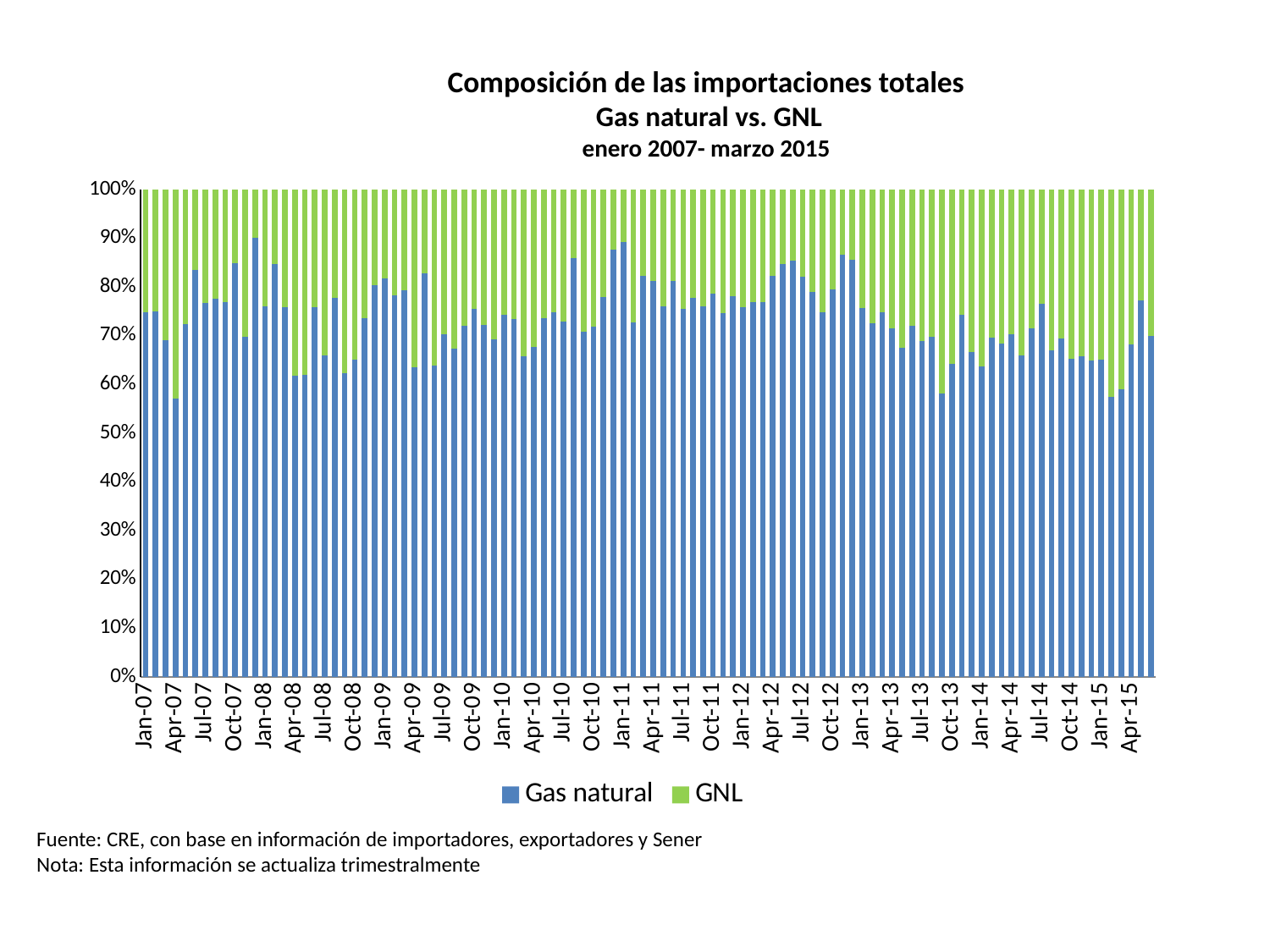
Is the Gas natural share for Jan-07 greater or less than 60%? greater Which month has the larger GNL share, Jan-12 or Jan-14? Jan-14 Which month has the larger Gas natural share, Jan-07 or Jan-15? Jan-07 Is the GNL share for Jan-15 greater or less than 30%? greater What is the total of the stacked bar for Jan-07? 100% What kind of chart is shown on the slide? Stacked bar chart Is the Gas natural share for Jan-12 greater or less than 70%? greater What are the two series named in the legend? Gas natural and GNL How many series does the legend list? 2 What colour represents GNL in the chart? Green